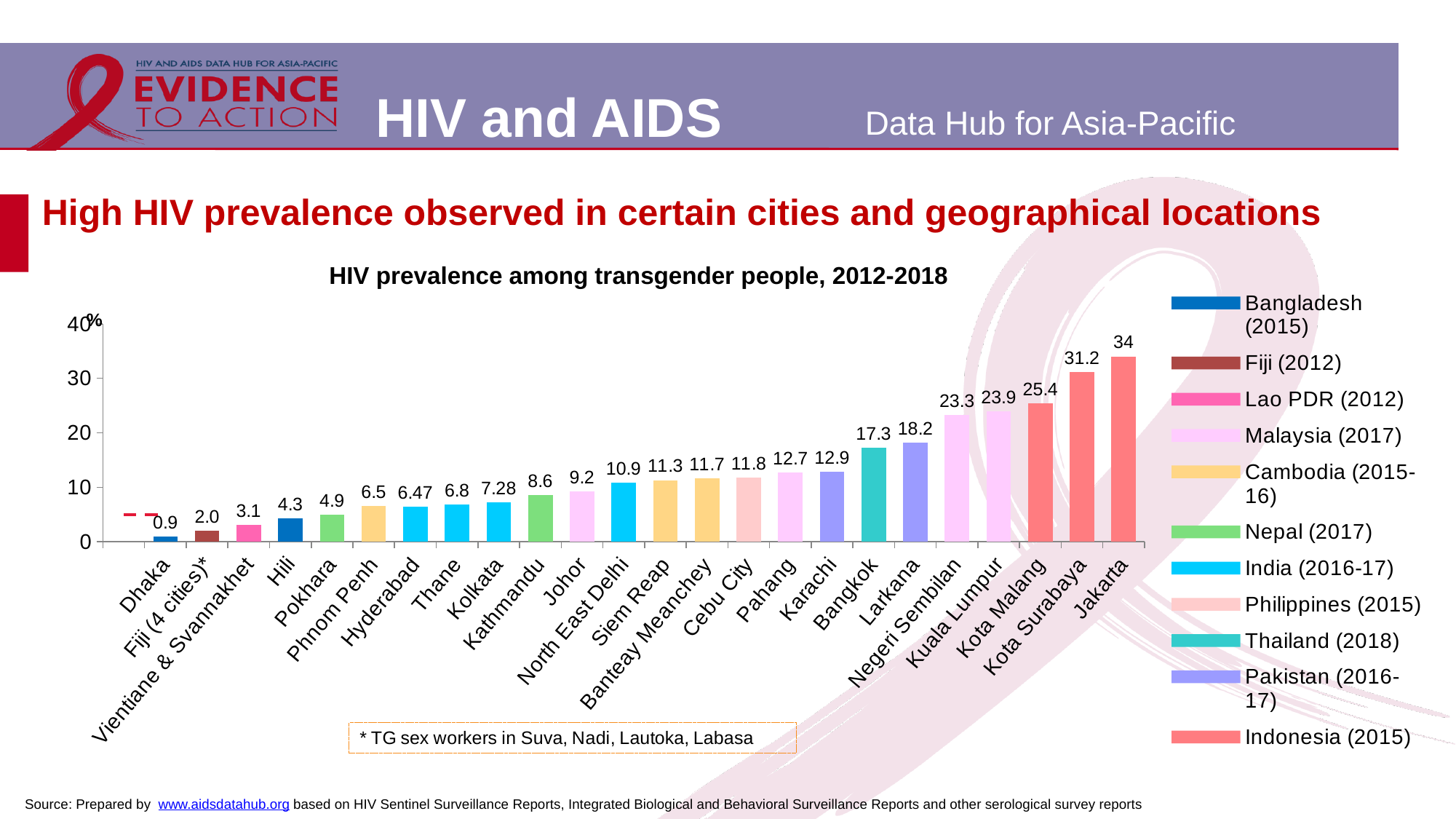
Which city has the lowest HIV prevalence in the chart? Dhaka What is the HIV prevalence value shown for Phnom Penh? 6.5 Which city has the highest HIV prevalence in the chart? Jakarta How many entries does the legend list? 11 How many cities or locations are shown on the x axis of the chart? 24 What type of chart is used to show HIV prevalence among transgender people? Bar chart What is the difference between the values for Kota Surabaya and Kota Malang? 5.8 Is the value for Kuala Lumpur greater or less than 20? greater What is the HIV prevalence value shown for Jakarta? 34 What is the title of the chart? HIV prevalence among transgender people, 2012-2018 What is the HIV prevalence value shown for Bangkok? 17.3 Which has a higher HIV prevalence value, Larkana or Karachi? Larkana